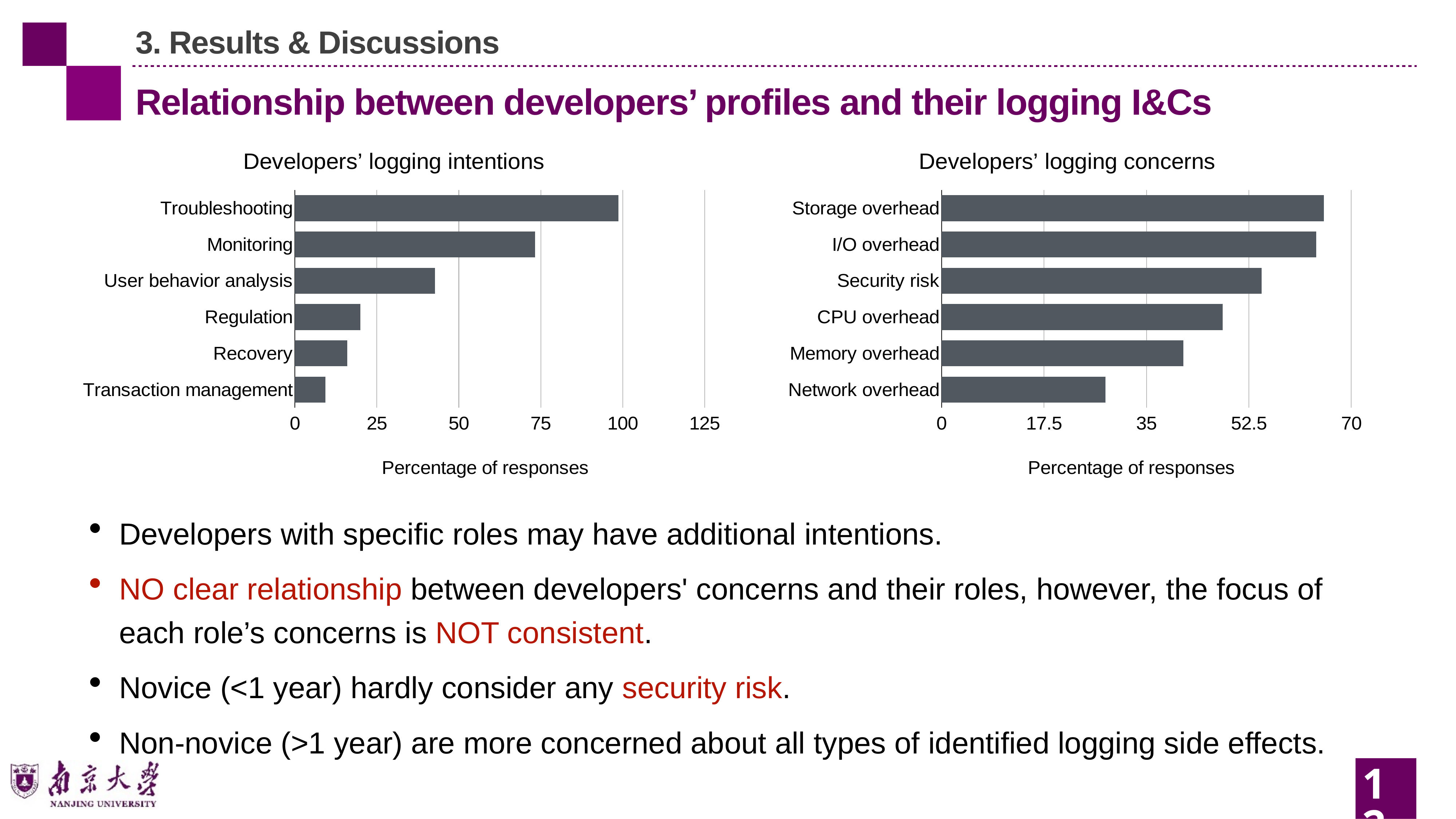
In the 'Developers' logging concerns' chart, is the value for Security risk greater or less than 52.5? greater In the 'Developers' logging intentions' chart, which category has the lowest value? Transaction management In the 'Developers' logging intentions' chart, which is larger, Monitoring or Regulation? Monitoring What type of chart is the 'Developers' logging concerns' chart? Bar chart In the 'Developers' logging concerns' chart, which is larger, CPU overhead or Memory overhead? CPU overhead In the 'Developers' logging concerns' chart, is the value for Network overhead greater or less than 35? less In the 'Developers' logging intentions' chart, which category has the highest value? Troubleshooting In the 'Developers' logging intentions' chart, is the value for Troubleshooting greater or less than 75? greater How many categories are shown in the 'Developers' logging intentions' chart? 6 What is the x-axis label of the 'Developers' logging intentions' chart? Percentage of responses In the 'Developers' logging concerns' chart, which category has the lowest value? Network overhead